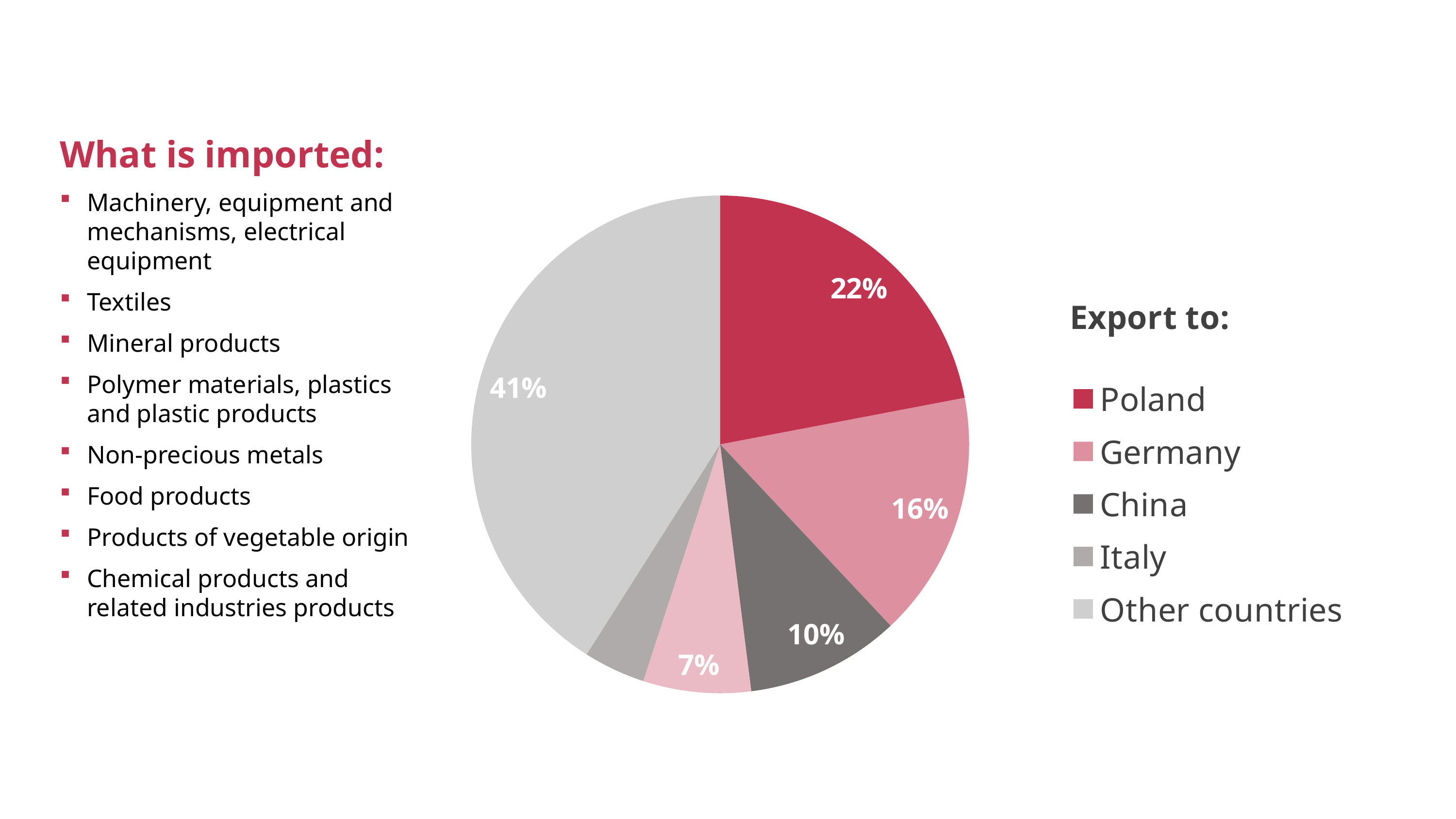
What kind of chart is shown on the slide? pie chart What share of the pie is taken by Other countries? 41% What share of exports goes to China? 10% What is the difference between the shares for Poland and Germany? 6% What is the difference between the shares for Germany and China? 6% What share of exports goes to Poland? 22% Which legend category has the largest slice of the pie? Other countries How many entries does the legend of the pie chart list? 5 Which colour represents Poland in the pie chart? dark red Which is larger, the share for Poland or the share for Germany? Poland What is the title of the pie chart? Export to: What share of exports goes to Germany? 16%